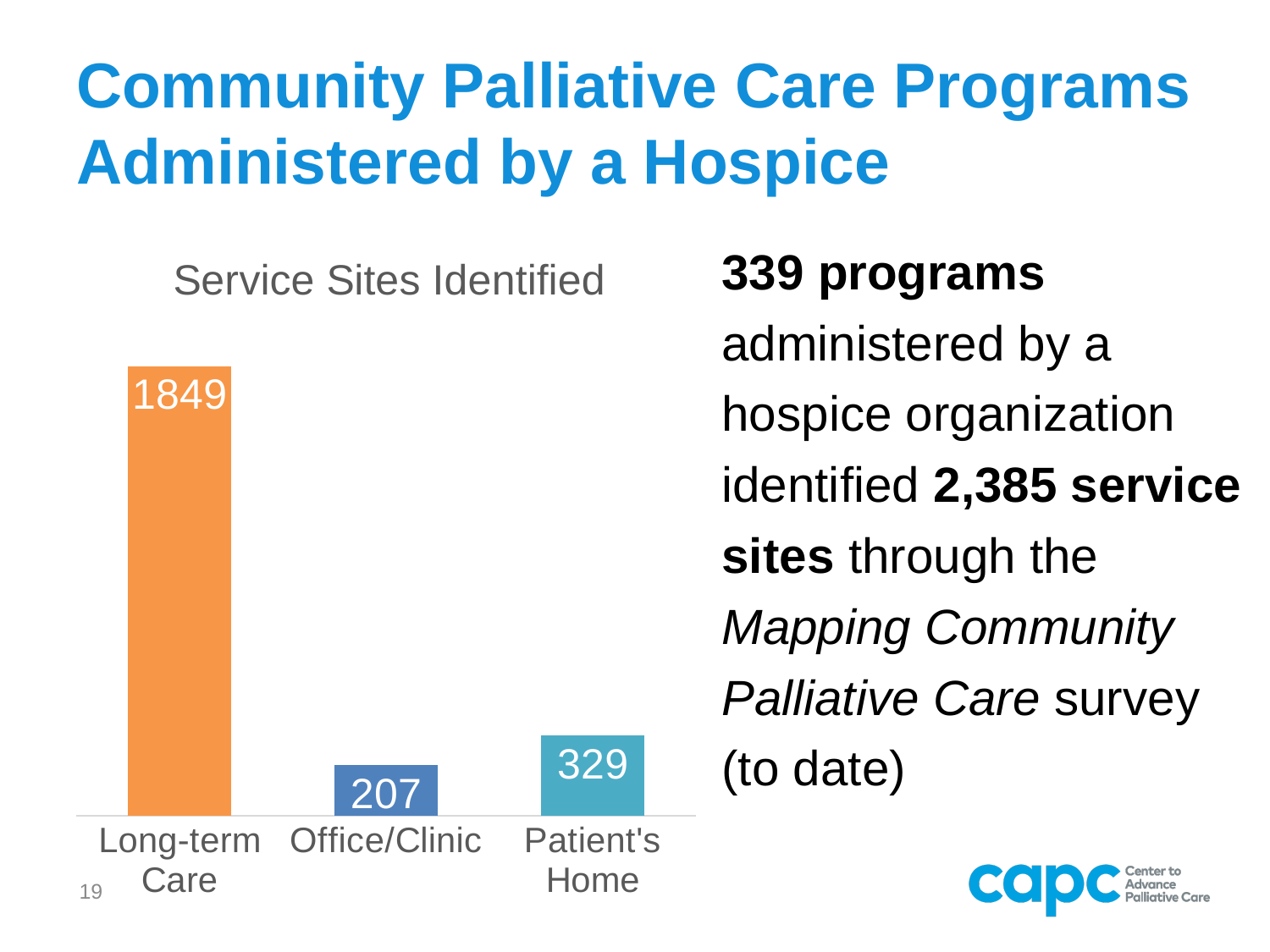
How many categories are shown in the Service Sites Identified chart? 3 What is the difference between the Patient's Home and Office/Clinic values in the Service Sites Identified chart? 122 What kind of chart is the Service Sites Identified chart? Bar chart What is the title of the chart on the slide? Service Sites Identified Which category has the highest value in the Service Sites Identified chart? Long-term Care Which is larger in the Service Sites Identified chart: Office/Clinic or Patient's Home? Patient's Home What is the value for Long-term Care in the Service Sites Identified chart? 1849 What is the difference between the Long-term Care and Patient's Home values in the Service Sites Identified chart? 1520 What is the value for Office/Clinic in the Service Sites Identified chart? 207 What colour is the Long-term Care bar in the Service Sites Identified chart? Orange What is the value for Patient's Home in the Service Sites Identified chart? 329 Which category has the lowest value in the Service Sites Identified chart? Office/Clinic